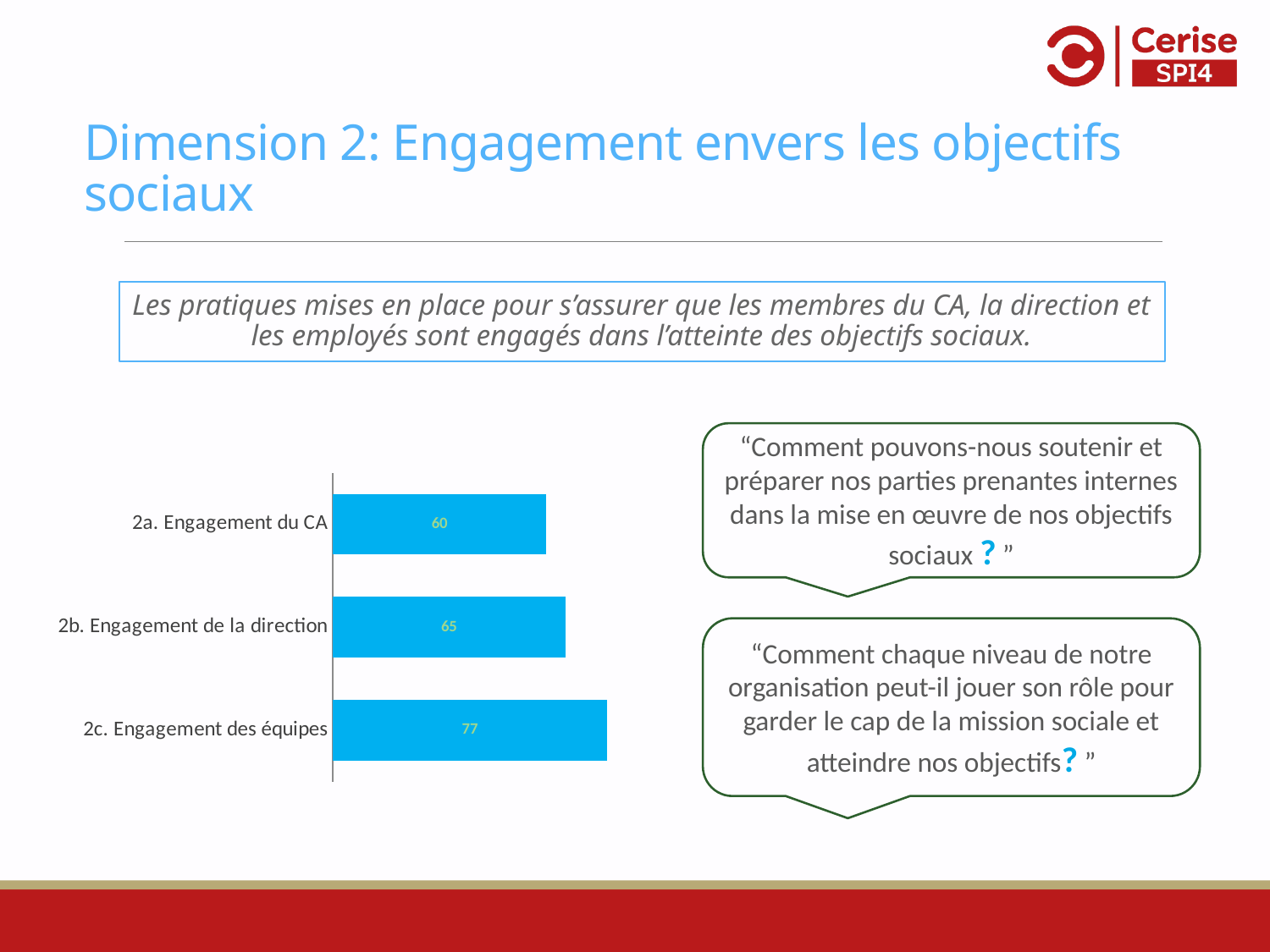
Are the bars in the chart horizontal or vertical? Horizontal What is the value for 2b. Engagement de la direction? 65 Which category has the lowest value? 2a. Engagement du CA How many categories are shown in the chart? 3 What is the value for 2c. Engagement des équipes? 77 Which is larger, the value for 2b. Engagement de la direction or the value for 2c. Engagement des équipes? 2c. Engagement des équipes What is the difference between the values for 2b. Engagement de la direction and 2a. Engagement du CA? 5 What colour are the bars in the chart? Blue What kind of chart is shown on the slide? Bar chart Which category has the highest value? 2c. Engagement des équipes What is the difference between the values for 2c. Engagement des équipes and 2a. Engagement du CA? 17 What is the value for 2a. Engagement du CA? 60